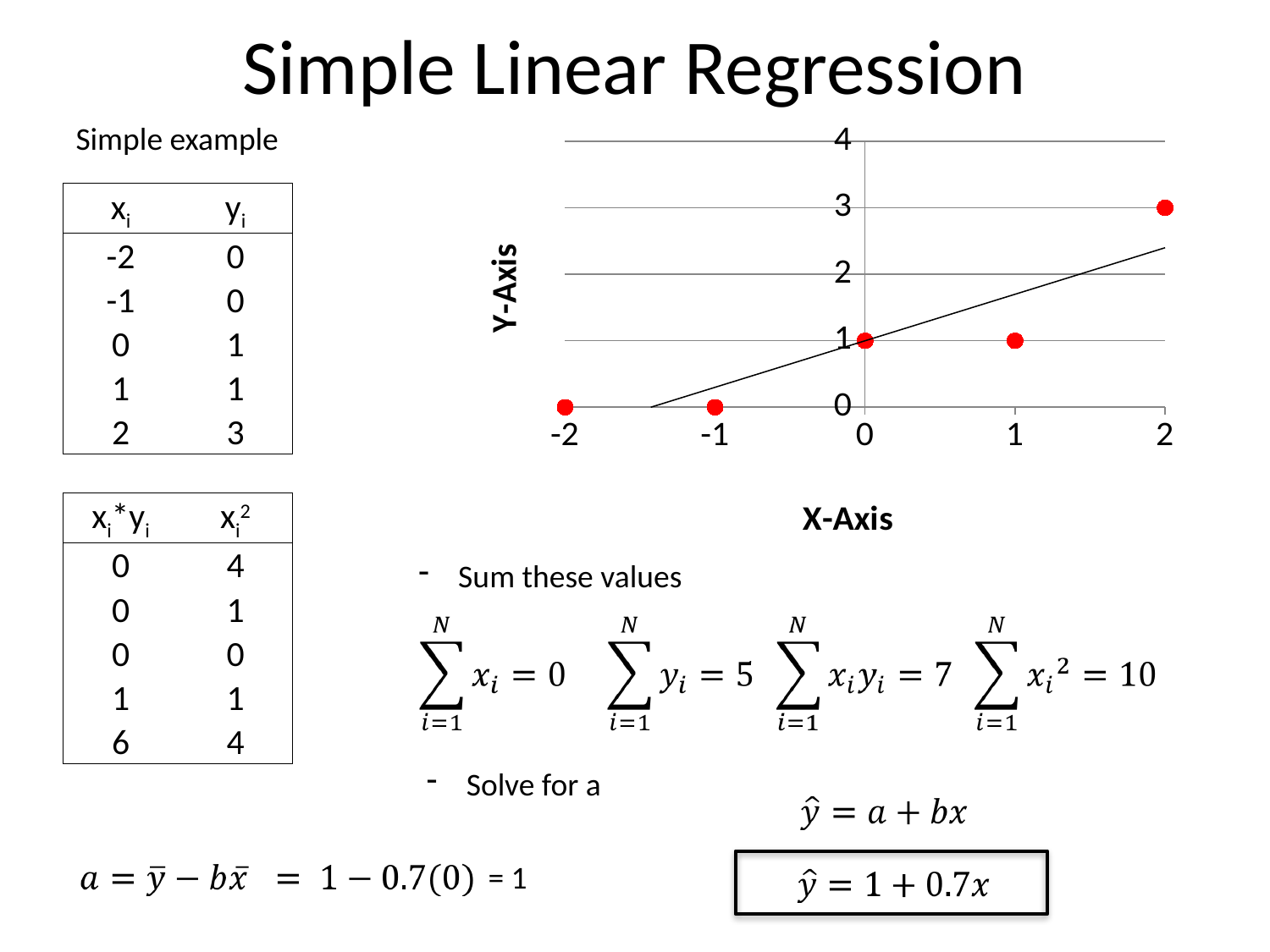
Is the y value of the point at x = 2 greater or less than 2? greater What kind of chart is shown on the slide? scatter plot What is the difference between the y values at x = 2 and x = 1? 2 What is the y value of the point at x = 0? 1 What colour are the plotted data points? red What is the y value of the point at x = 2? 3 How many data points are plotted on the chart? 5 At which x value does the plotted point have the highest y value? 2 Which point has a larger y value, the one at x = 0 or the one at x = -1? x = 0 Do the plotted y values generally rise or fall as x increases? rise What is the y value of the point at x = -2? 0 What is the title of the horizontal axis of the chart? X-Axis